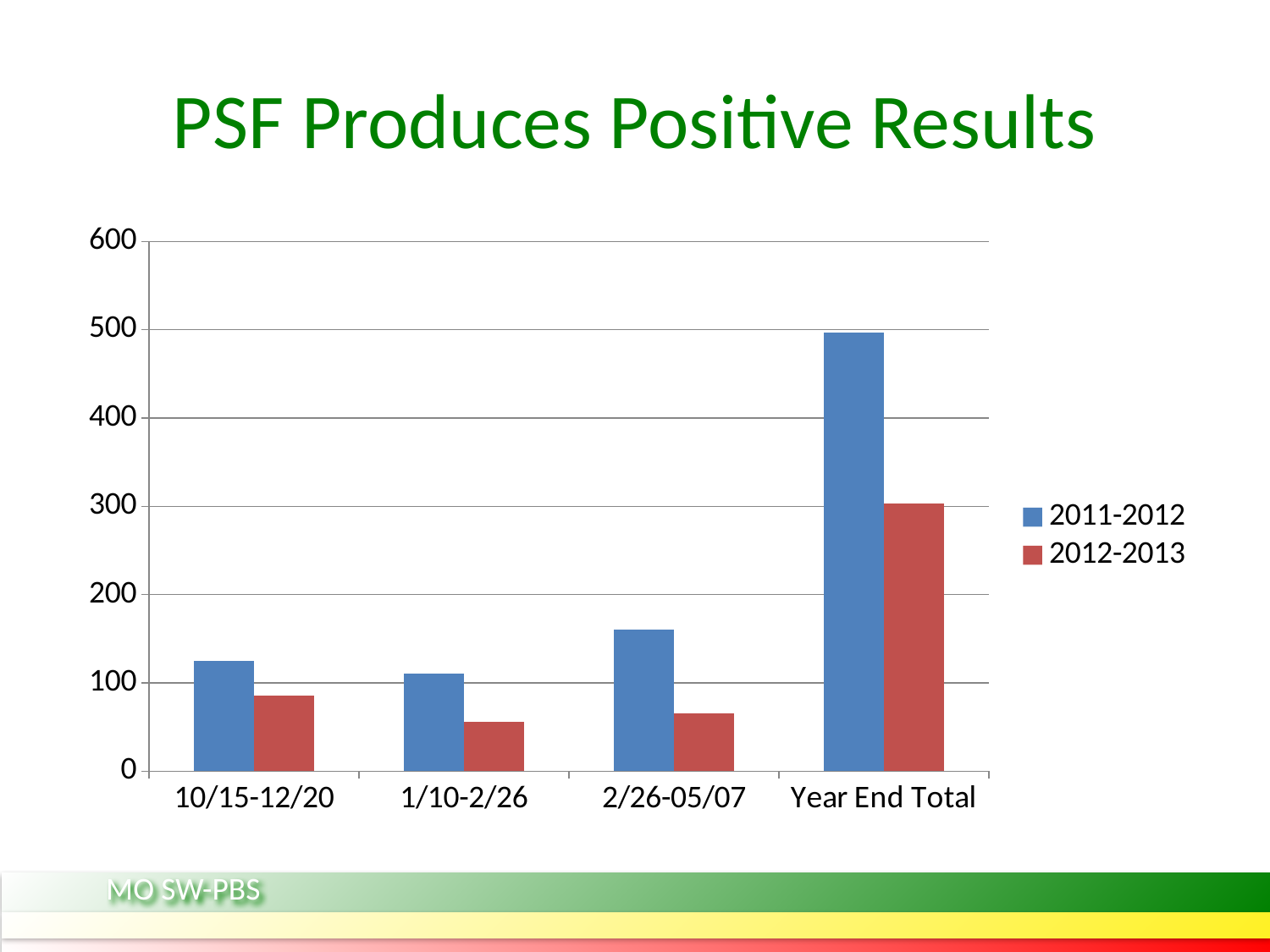
Is the Year End Total value for 2011-2012 greater or less than 400? greater Which category has the highest value for the 2012-2013 series? Year End Total Is the Year End Total value for 2012-2013 greater or less than 200? greater Is the value for 1/10-2/26 in the 2012-2013 series greater or less than 100? less Which category has the highest value for the 2011-2012 series? Year End Total For the Year End Total, which series has the larger value, 2011-2012 or 2012-2013? 2011-2012 What kind of chart is shown on the slide? bar chart Which category has the lowest value for the 2011-2012 series? 1/10-2/26 How many series does the legend list? 2 How many categories are shown on the x axis? 4 What is the title of the chart slide? PSF Produces Positive Results